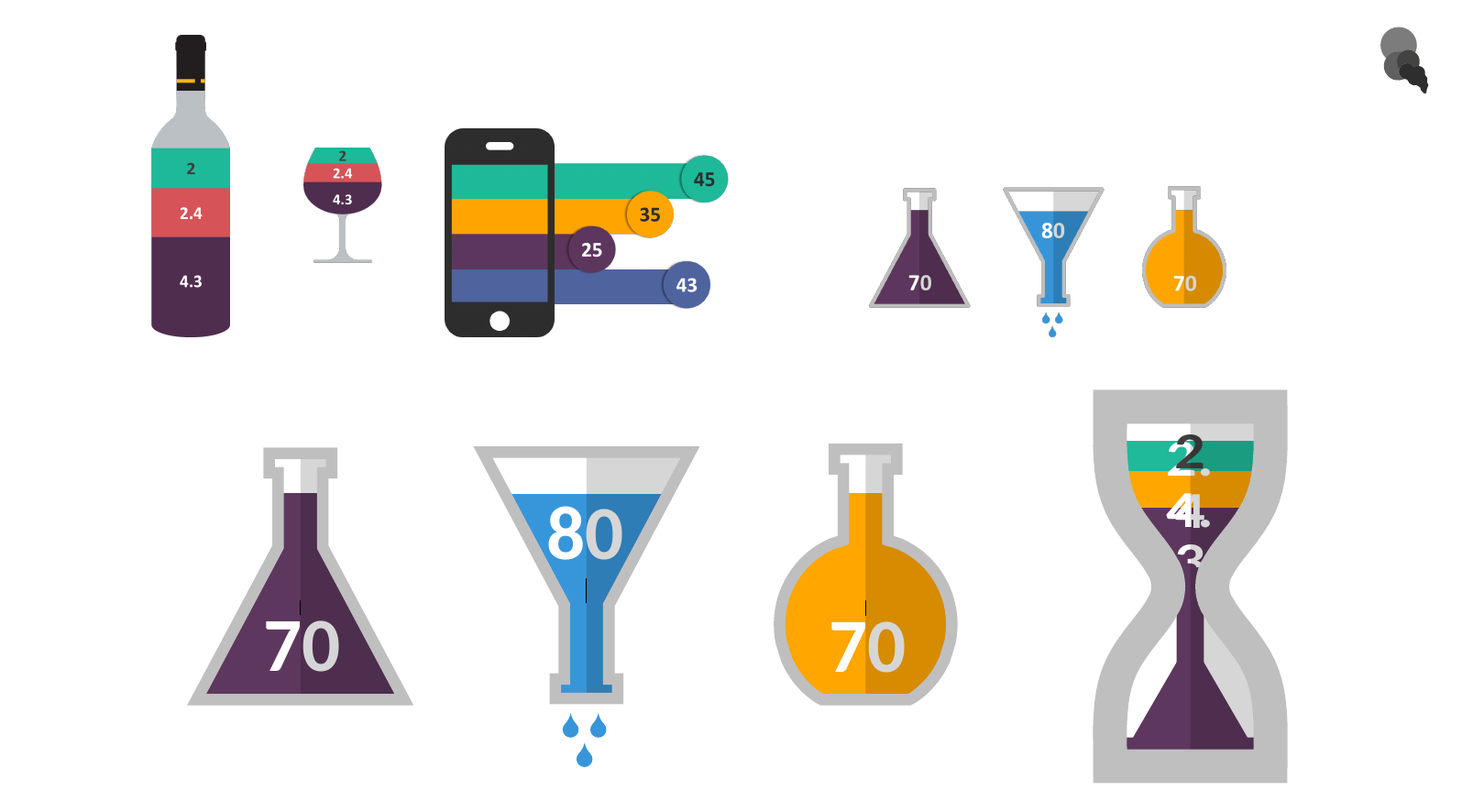
On the phone chart in the top middle, what value is shown on the orange bar? 35 On the wine bottle chart at the top left, what is the total of the three segments (2, 2.4 and 4.3)? 8.7 On the wine bottle chart at the top left, how many segments are stacked? 3 On the phone chart in the top middle, what value is shown on the bottom (blue) bar? 43 On the phone chart in the top middle, which bar has the highest value? The green bar (45) On the phone chart in the top middle, which bar has the lowest value? The purple bar (25) What value is shown on the large blue funnel chart in the bottom row? 80 What kind of chart is shown next to the phone in the top middle? Bar chart On the phone chart in the top middle, what is the difference between the highest bar (45) and the lowest bar (25)? 20 On the phone chart in the top middle, how many bars are plotted? 4 On the wine bottle chart at the top left, what value is shown on the bottom (purple) segment? 4.3 On the phone chart in the top middle, what value is shown on the top (green) bar? 45